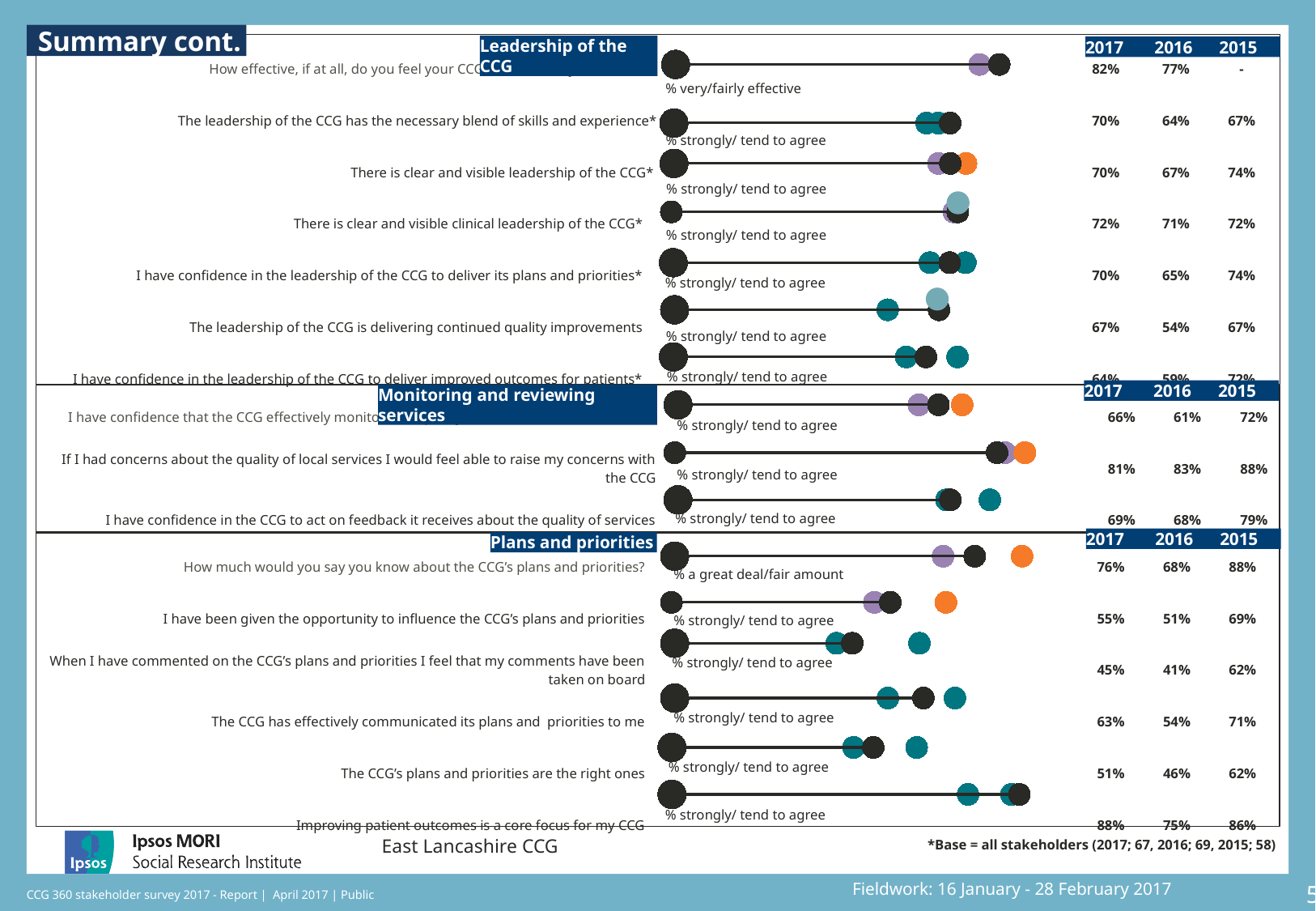
Which three years are shown as columns in the tables on the slide? 2017, 2016, 2015 In the Monitoring and reviewing services section, what is the 2015 value for 'If I had concerns about the quality of local services I would feel able to raise my concerns with the CCG'? 88% In the Plans and priorities section, which statement has the lowest 2017 value? When I have commented on the CCG's plans and priorities I feel that my comments have been taken on board In the Plans and priorities section, is the 2017 value for 'The CCG has effectively communicated its plans and priorities to me' higher or lower than its 2016 value? higher In the Monitoring and reviewing services section, which statement has the highest 2017 value? If I had concerns about the quality of local services I would feel able to raise my concerns with the CCG In the Leadership of the CCG section, what is the 2017 value for 'The leadership of the CCG has the necessary blend of skills and experience'? 70% In the Plans and priorities section, what is the difference between the 2015 and 2017 values for 'I have been given the opportunity to influence the CCG's plans and priorities'? 14 percentage points In the Monitoring and reviewing services section, is the 2017 value for 'If I had concerns about the quality of local services I would feel able to raise my concerns with the CCG' higher or lower than its 2016 value? lower In the Plans and priorities section, what is the 2017 value for 'When I have commented on the CCG's plans and priorities I feel that my comments have been taken on board'? 45% In the Leadership of the CCG section, what is the difference between the 2017 and 2016 values for 'The leadership of the CCG is delivering continued quality improvements'? 13 percentage points In the Leadership of the CCG section, what is the 2016 value for 'The leadership of the CCG is delivering continued quality improvements'? 54% How many statements are listed in the Monitoring and reviewing services section? 3